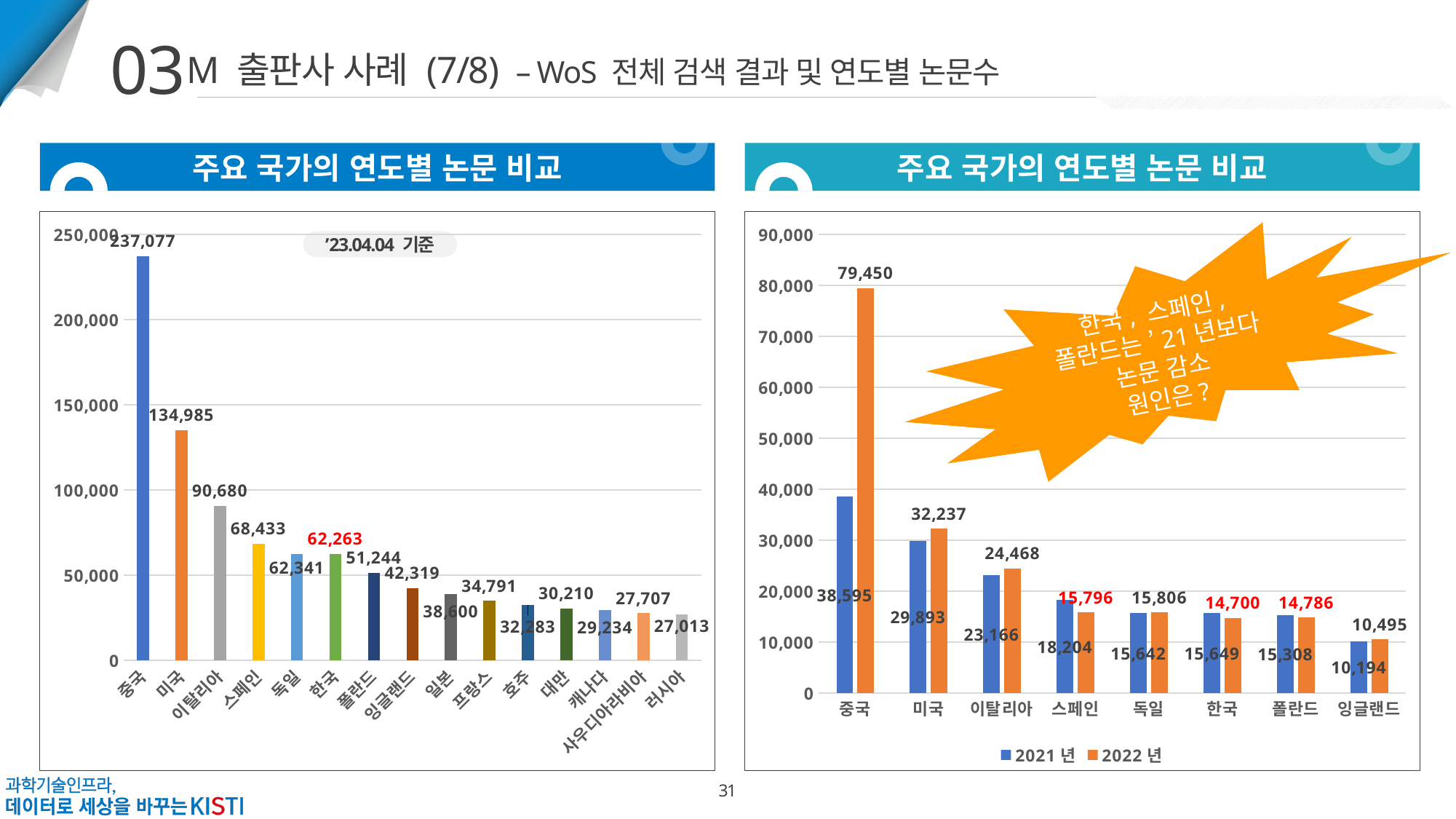
In the left chart, which country has the lowest value? 러시아 In the left chart, what is the value for 중국? 237,077 In the left chart, what is the difference between the values for 미국 and 이탈리아? 44,305 In the right chart, which country has the highest 2022 년 value? 중국 In the right chart, what is the 2021 년 value for 스페인? 18,204 In the right chart, which is larger for 한국: the 2021 년 value or the 2022 년 value? 2021 년 In the right chart, what is the difference between the 2022 년 and 2021 년 values for 중국? 40,855 In the left chart, what kind of chart is shown? bar chart In the right chart, how many series does the legend list? 2 In the left chart, what is the value for 폴란드? 51,244 In the left chart, how many countries are shown on the x axis? 15 In the right chart, what is the 2022 년 value for 중국? 79,450